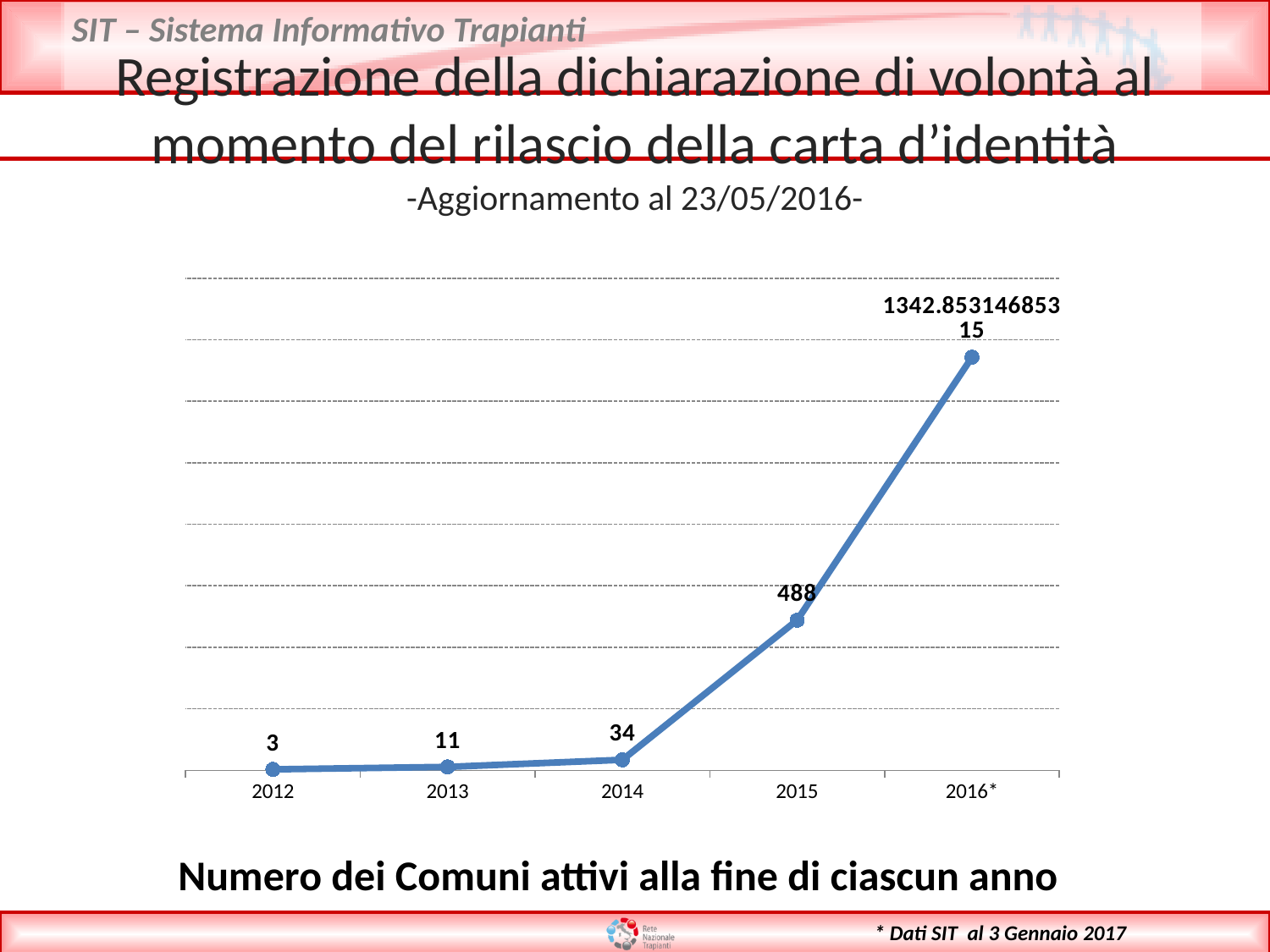
What is the difference between the values for 2013 and 2012? 8 What is the value for 2014? 34 What is the difference between the values for 2015 and 2014? 454 Do the values rise or fall from 2012 to 2016*? rise Which is larger, the value for 2014 or the value for 2013? 2014 What is the value for 2013? 11 What is the value for 2012? 3 Which year has the lowest value? 2012 Which year has the highest value? 2016* What is the value for 2015? 488 How many data points are plotted on the chart? 5 What type of chart is shown on the slide? line chart